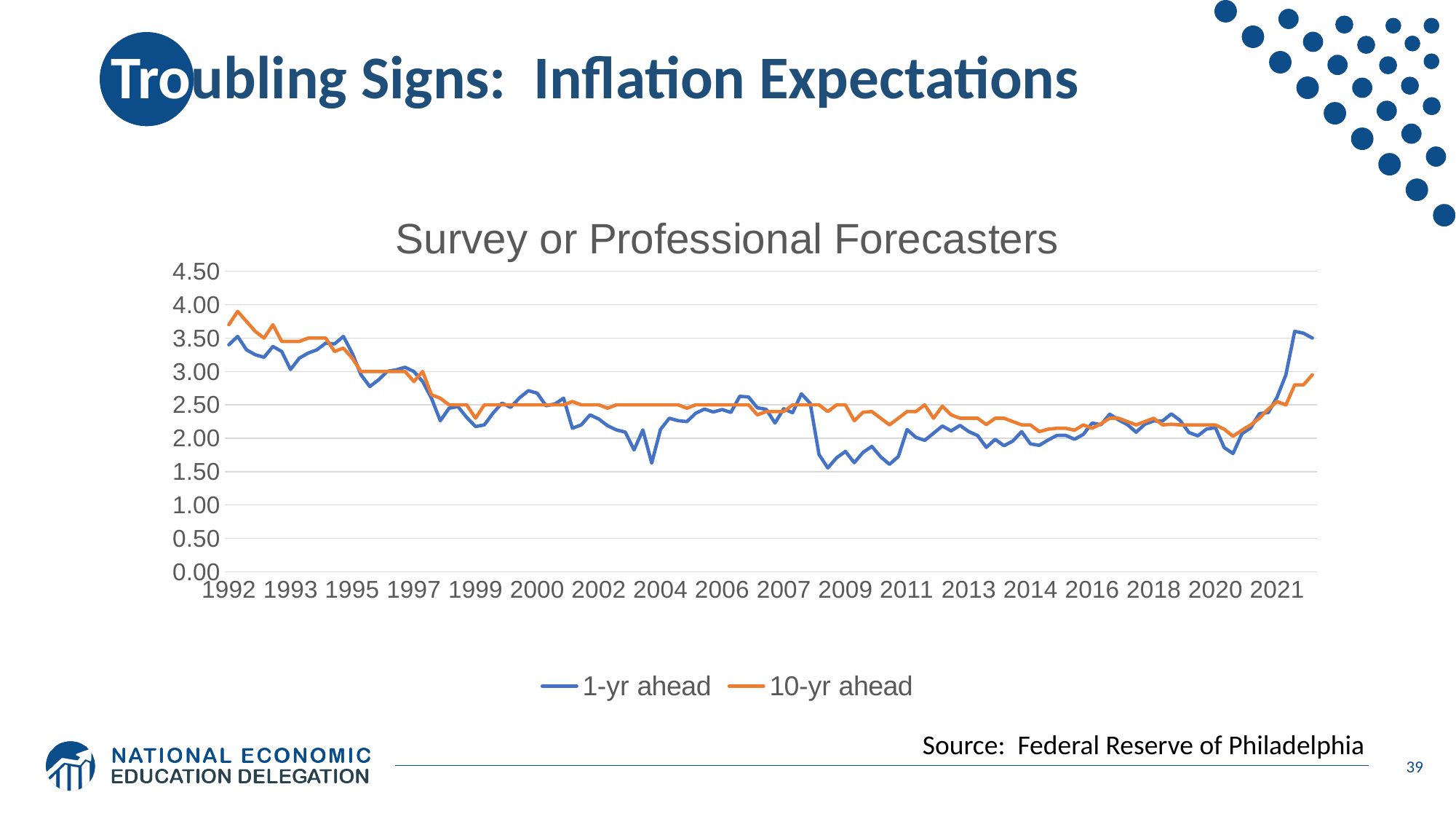
Is the lowest value for 1-yr ahead around 2009 greater or less than 2.00? less Is the value for 10-yr ahead at the end of the series in 2021 greater or less than 2.50? greater Is the value for 10-yr ahead at the start of 1992 greater or less than 3.50? greater Does the 10-yr ahead series generally rise or fall from 1992 to 2013? fall How many year labels are shown on the x axis? 18 Around 2009, which series has the higher value, 1-yr ahead or 10-yr ahead? 10-yr ahead What kind of chart is shown on the slide? line chart What is the title of the chart? Survey or Professional Forecasters Which series is drawn in orange? 10-yr ahead How many series does the legend list? 2 At the end of the series in 2021, which series has the higher value, 1-yr ahead or 10-yr ahead? 1-yr ahead